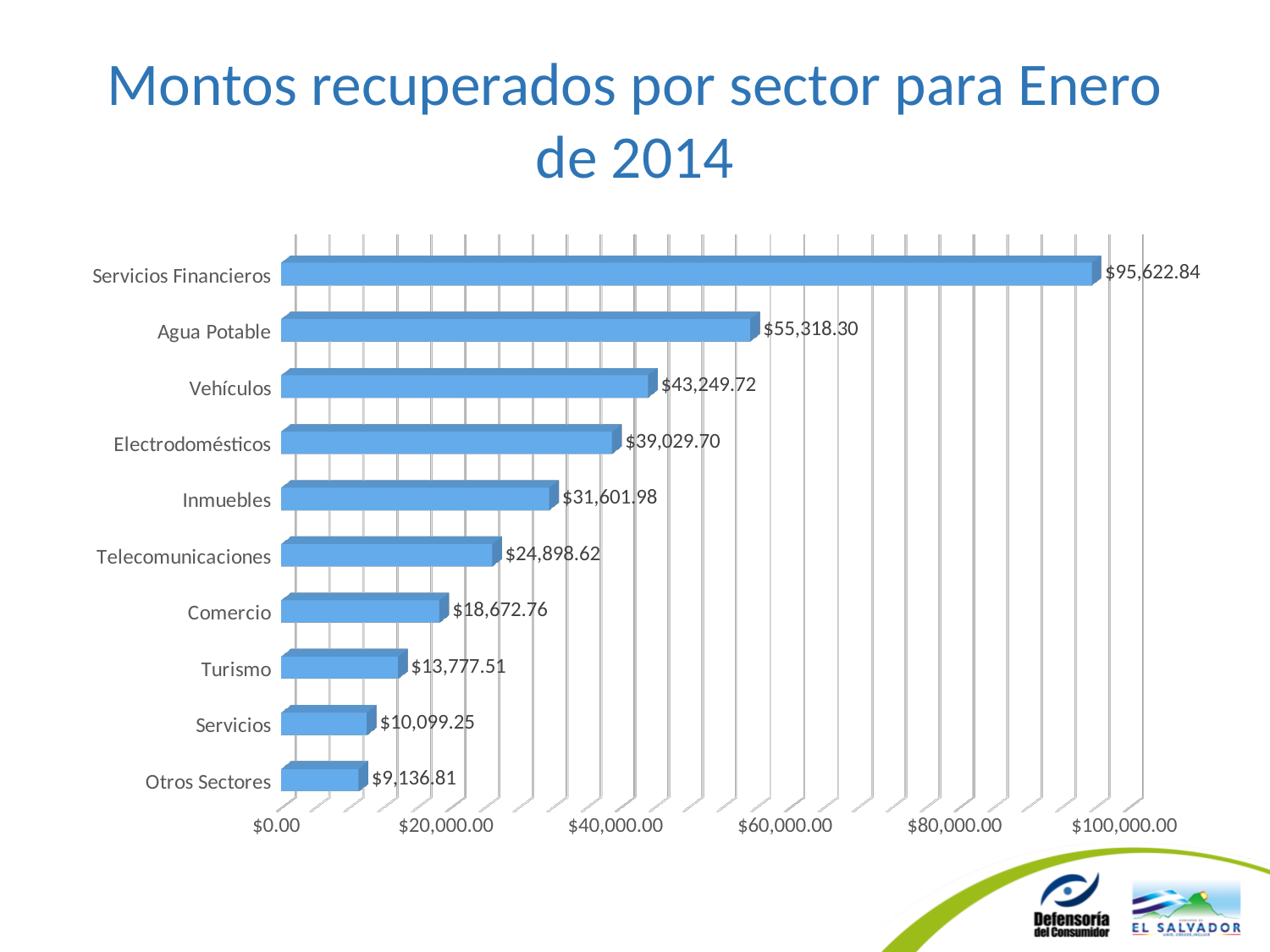
What is the value for Telecomunicaciones? $24,898.62 How many sectors are shown in the chart? 10 Which sector has the highest recovered amount? Servicios Financieros What is the difference between the values for Vehículos and Electrodomésticos? $4,220.02 What is the value for Turismo? $13,777.51 What is the title of the chart? Montos recuperados por sector para Enero de 2014 Is the value for Comercio greater or less than $20,000.00? less What kind of chart is shown on the slide? bar chart What is the value for Servicios Financieros? $95,622.84 Which is larger, the value for Inmuebles or the value for Comercio? Inmuebles What is the difference between the values for Servicios Financieros and Agua Potable? $40,304.54 Which sector has the lowest recovered amount? Otros Sectores